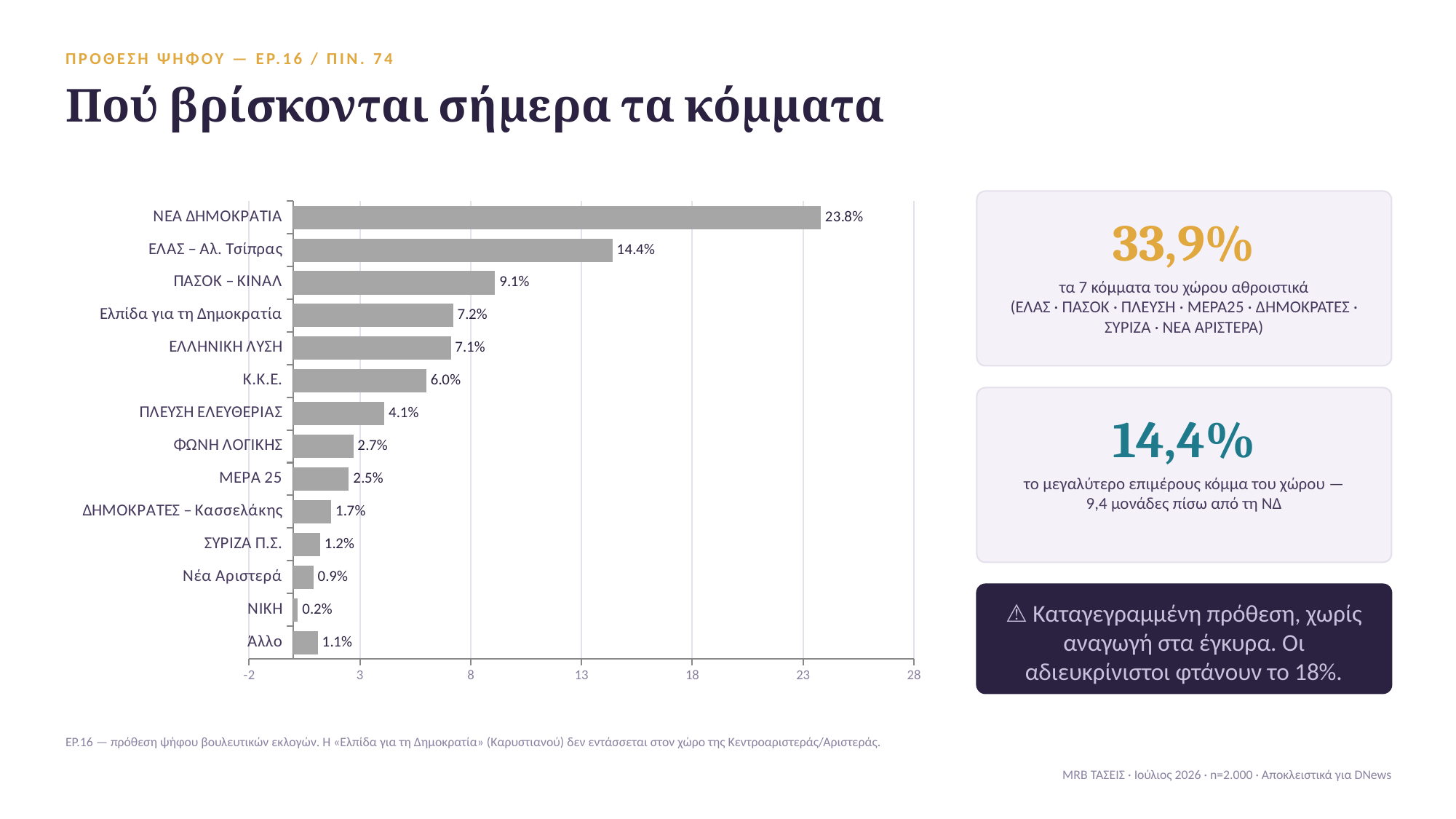
What is the value for ΠΑΣΟΚ – ΚΙΝΑΛ? 9.1% What kind of chart is shown on the slide? bar chart Which category has the lowest value? ΝΙΚΗ How many categories are shown in the chart? 14 What is the difference between the values for ΝΕΑ ΔΗΜΟΚΡΑΤΙΑ and ΕΛΑΣ – Αλ. Τσίπρας? 9.4 What is the value for ΝΕΑ ΔΗΜΟΚΡΑΤΙΑ? 23.8% Is the value for ΕΛΑΣ – Αλ. Τσίπρας greater or less than 13? greater What is the title of the slide? Πού βρίσκονται σήμερα τα κόμματα What is the value for Κ.Κ.Ε.? 6.0% Which is larger, the value for ΦΩΝΗ ΛΟΓΙΚΗΣ or the value for ΜΕΡΑ 25? ΦΩΝΗ ΛΟΓΙΚΗΣ Which category has the highest value? ΝΕΑ ΔΗΜΟΚΡΑΤΙΑ What is the value for ΝΙΚΗ? 0.2%